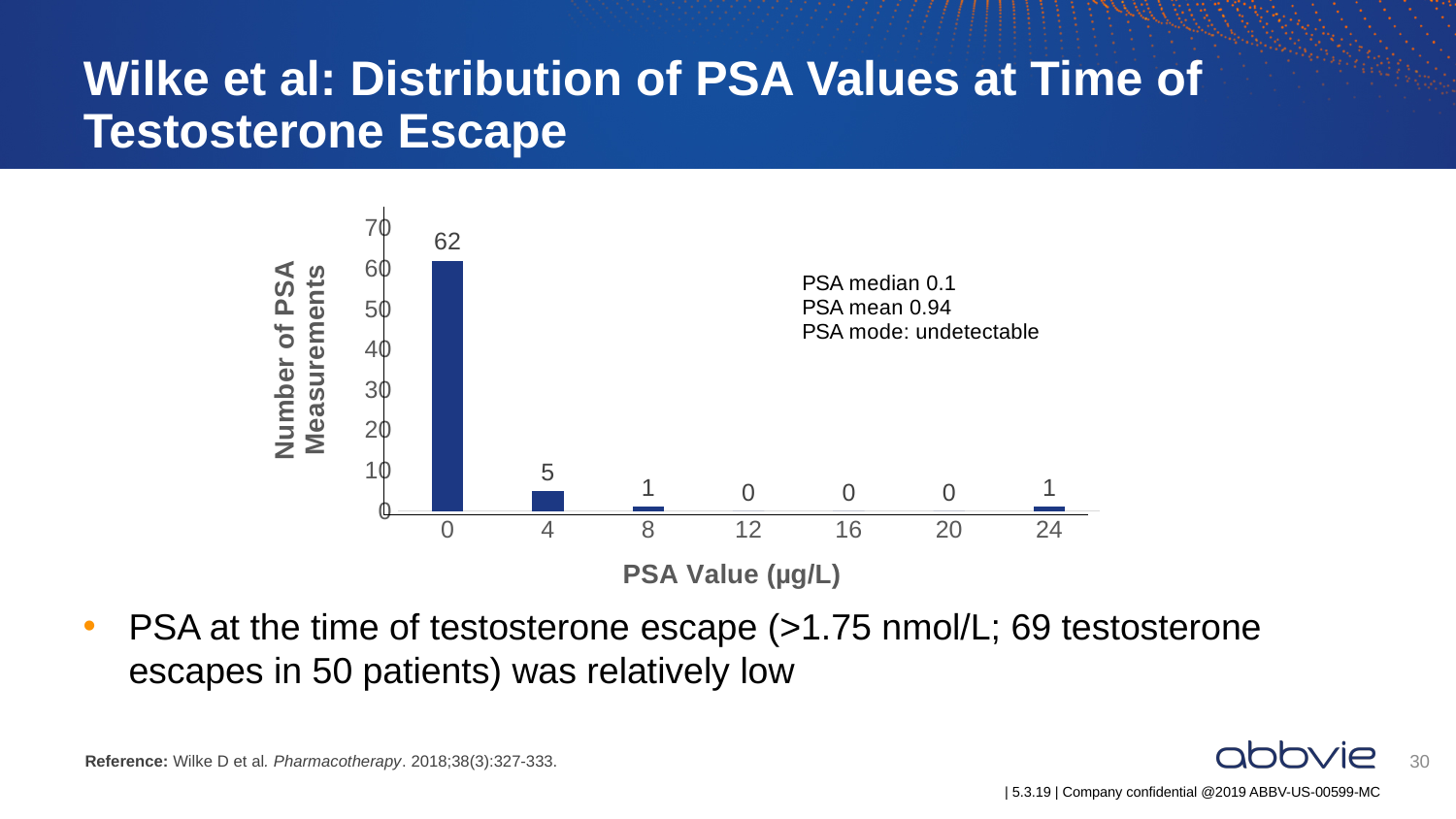
Which has more measurements: PSA value 4 or PSA value 8? PSA value 4 How many PSA measurements are shown for a PSA value of 12 µg/L? 0 What is the label of the x axis? PSA Value (µg/L) What PSA median value is stated on the chart? 0.1 Is the number of measurements at PSA value 0 greater or less than 60? greater How many PSA value categories are shown on the x axis? 7 What kind of chart is shown on the slide? bar chart Which PSA value category has the highest number of measurements? 0 What is the difference between the number of measurements at PSA value 0 and at PSA value 4? 57 How many PSA measurements are shown for a PSA value of 24 µg/L? 1 How many PSA measurements are shown for a PSA value of 0 µg/L? 62 How many PSA measurements are shown for a PSA value of 4 µg/L? 5